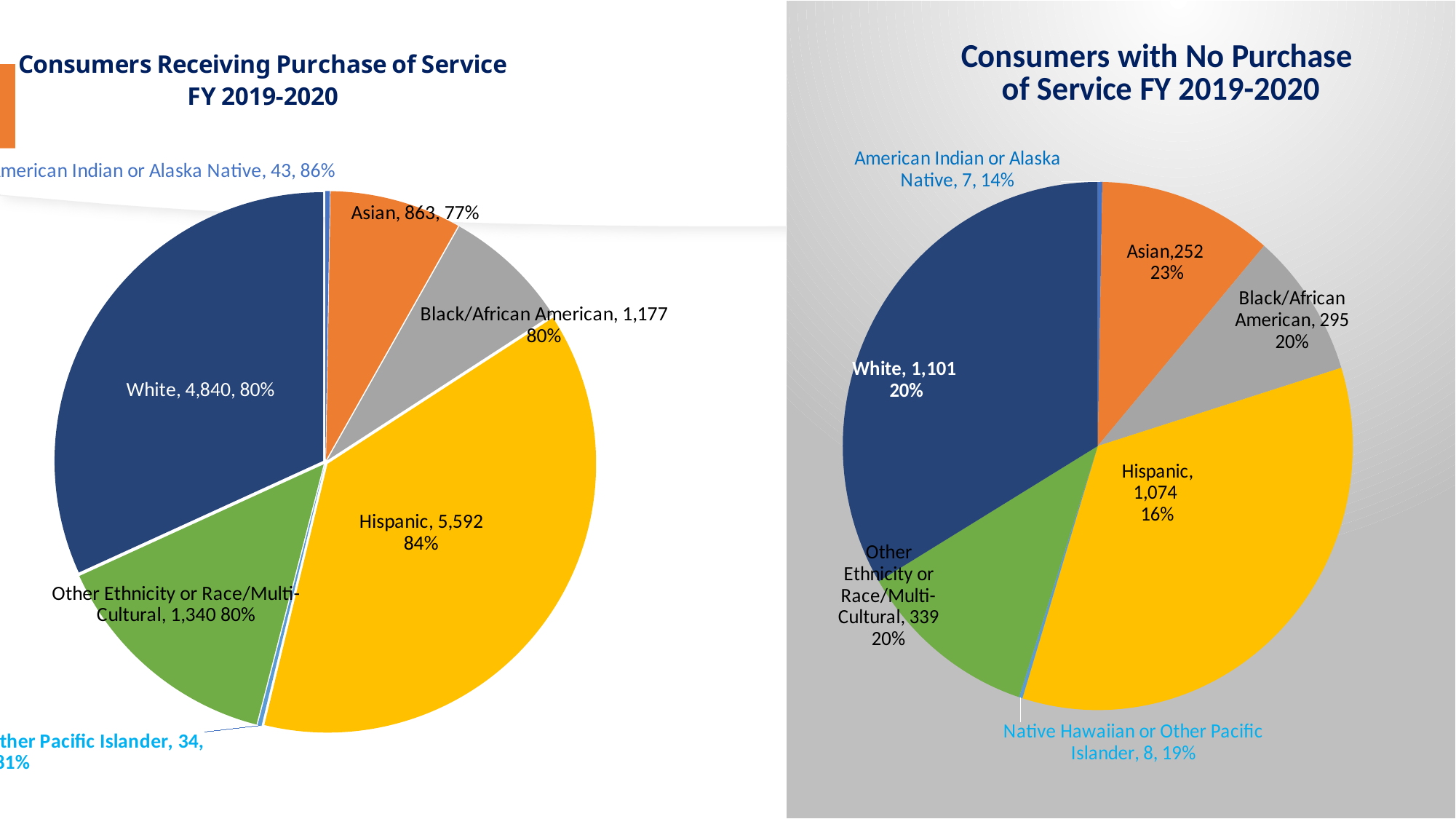
In the 'Consumers Receiving Purchase of Service FY 2019-2020' chart, which is larger, Black/African American or Other Ethnicity or Race/Multi-Cultural? Other Ethnicity or Race/Multi-Cultural In the 'Consumers with No Purchase of Service FY 2019-2020' chart, what is the difference between the Other Ethnicity or Race/Multi-Cultural count and the Asian count? 87 In the 'Consumers with No Purchase of Service FY 2019-2020' chart, what is the count for American Indian or Alaska Native? 7 In the 'Consumers Receiving Purchase of Service FY 2019-2020' chart, what is the count for Asian? 863 In the 'Consumers with No Purchase of Service FY 2019-2020' chart, how many consumers are White? 1,101 In the 'Consumers Receiving Purchase of Service FY 2019-2020' chart, how many consumers are Hispanic? 5,592 How many categories are shown in the 'Consumers with No Purchase of Service FY 2019-2020' chart? 7 What type of chart is used for 'Consumers Receiving Purchase of Service FY 2019-2020'? Pie chart In the 'Consumers Receiving Purchase of Service FY 2019-2020' chart, what is the difference between the Hispanic and White counts? 752 In the 'Consumers Receiving Purchase of Service FY 2019-2020' chart, which category has the largest slice? Hispanic In the 'Consumers Receiving Purchase of Service FY 2019-2020' chart, how many consumers are White? 4,840 In the 'Consumers with No Purchase of Service FY 2019-2020' chart, what is the count for Black/African American? 295